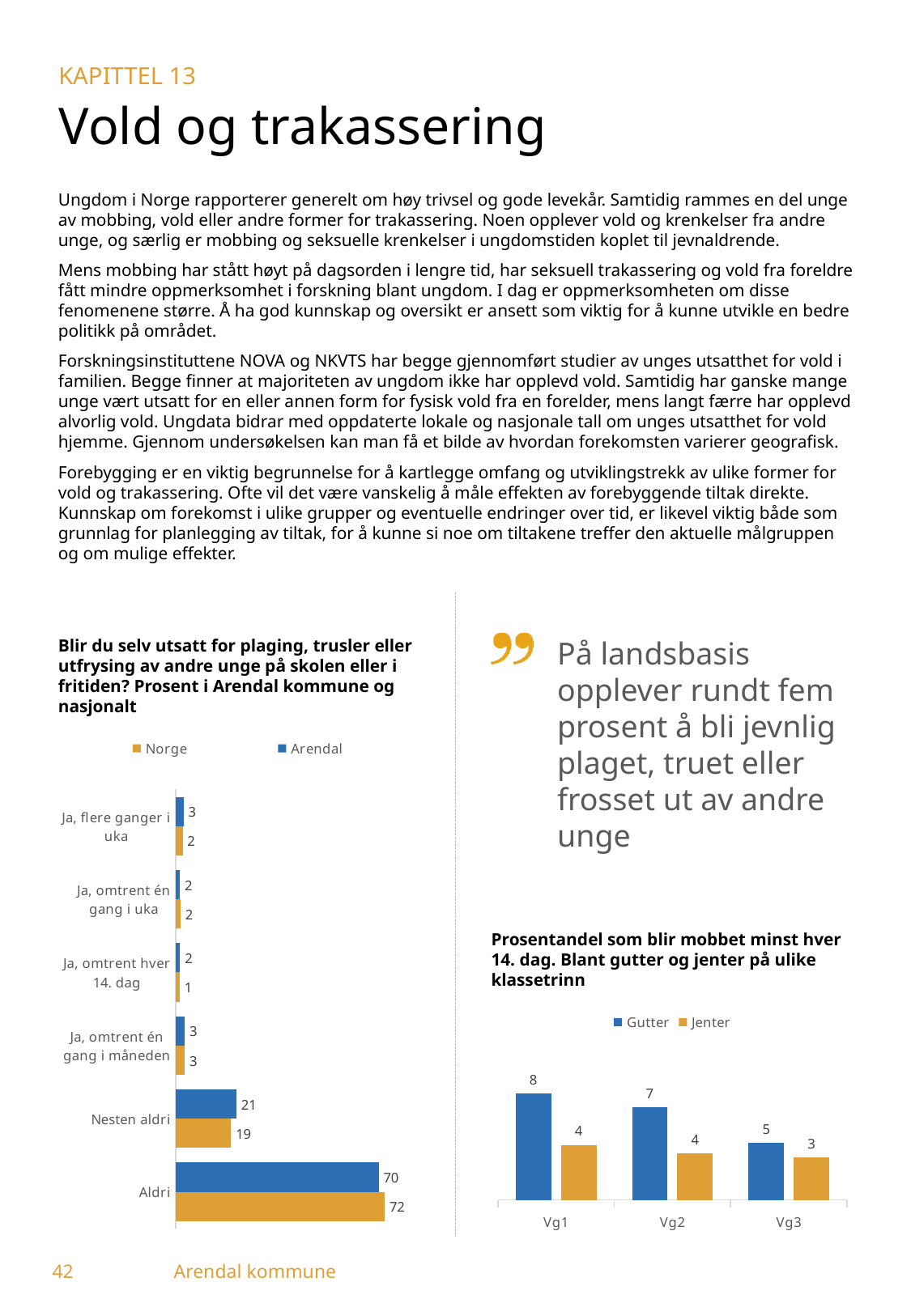
In the chart 'Prosentandel som blir mobbet minst hver 14. dag', what is the difference between Gutter and Jenter at Vg1? 4 In the chart 'Blir du selv utsatt for plaging, trusler eller utfrysing av andre unge på skolen eller i fritiden?', what is the value for Arendal for 'Nesten aldri'? 21 In the chart 'Prosentandel som blir mobbet minst hver 14. dag', what is the value for Gutter at Vg2? 7 In the chart 'Blir du selv utsatt for plaging, trusler eller utfrysing av andre unge på skolen eller i fritiden?', which is larger for 'Nesten aldri', Norge or Arendal? Arendal In the chart 'Blir du selv utsatt for plaging, trusler eller utfrysing av andre unge på skolen eller i fritiden?', how many series does the legend list? 2 In the chart 'Blir du selv utsatt for plaging, trusler eller utfrysing av andre unge på skolen eller i fritiden?', how many categories are shown? 6 In the chart 'Prosentandel som blir mobbet minst hver 14. dag', which colour represents Jenter? Orange In the chart 'Prosentandel som blir mobbet minst hver 14. dag', do the values for Gutter rise or fall from Vg1 to Vg3? Fall In the chart 'Blir du selv utsatt for plaging, trusler eller utfrysing av andre unge på skolen eller i fritiden?', which category has the highest value for Arendal? Aldri In the chart 'Blir du selv utsatt for plaging, trusler eller utfrysing av andre unge på skolen eller i fritiden?', what is the value for Norge for 'Aldri'? 72 In the chart 'Blir du selv utsatt for plaging, trusler eller utfrysing av andre unge på skolen eller i fritiden?', what is the difference between Norge and Arendal for 'Aldri'? 2 What kind of chart is 'Prosentandel som blir mobbet minst hver 14. dag'? Bar chart